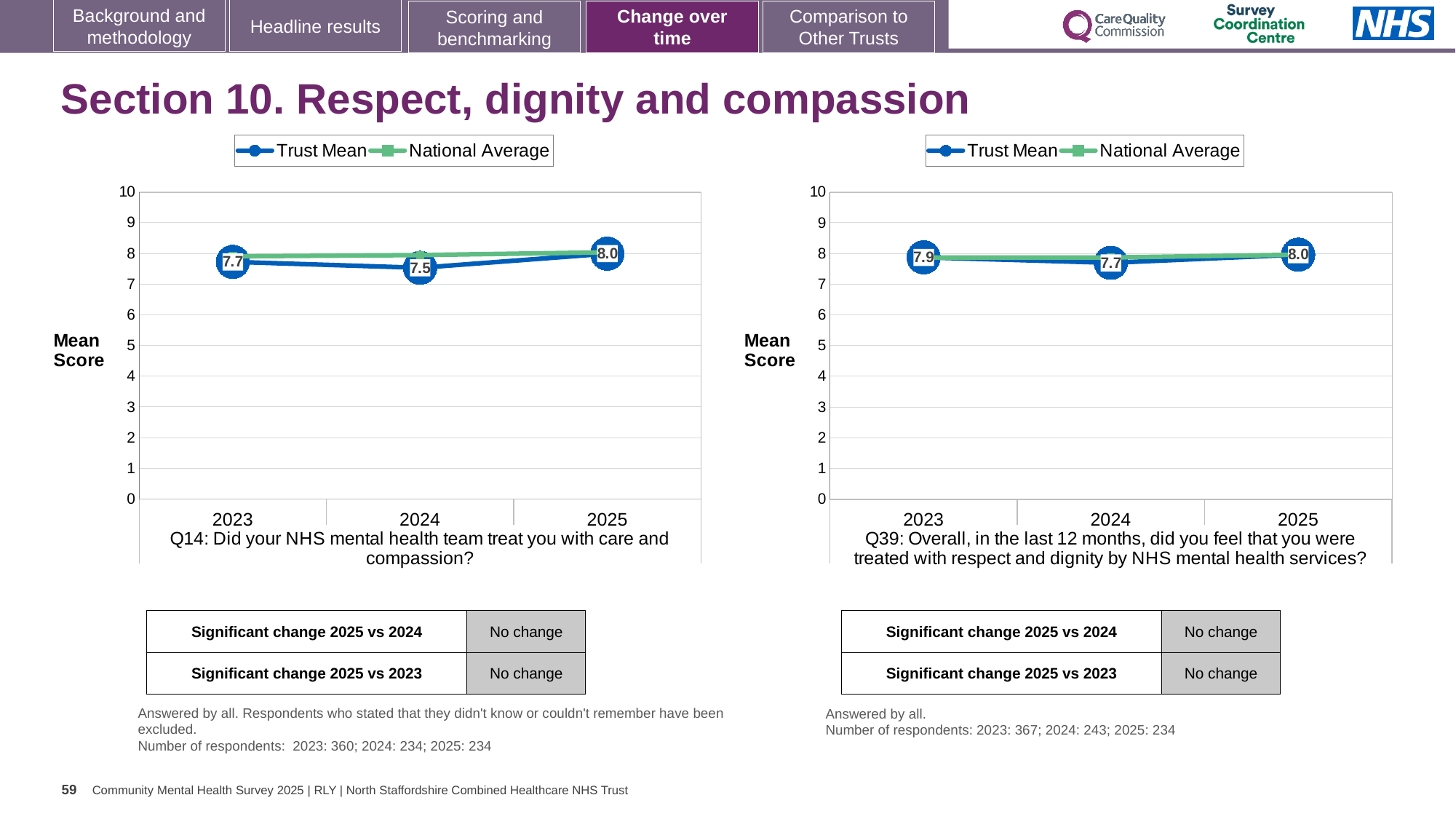
On the left chart (Q14), which year has the highest Trust Mean? 2025 On the left chart (Q14), is the Trust Mean for 2023 greater or less than 7? greater On the left chart (Q14), what is the difference between the Trust Mean for 2025 and the Trust Mean for 2024? 0.5 What type of chart is the left chart (Q14)? Line chart On the right chart (Q39), what is the Trust Mean for 2023? 7.9 On the left chart (Q14), what is the Trust Mean for 2024? 7.5 On the left chart (Q14), what is the Trust Mean for 2025? 8.0 How many series does the legend of the right chart (Q39) list? 2 On the right chart (Q39), what is the difference between the Trust Mean for 2025 and the Trust Mean for 2023? 0.1 On the left chart (Q14), which year has the lowest Trust Mean? 2024 On the right chart (Q39), what is the Trust Mean for 2024? 7.7 On the right chart (Q39), which year has the lowest Trust Mean? 2024